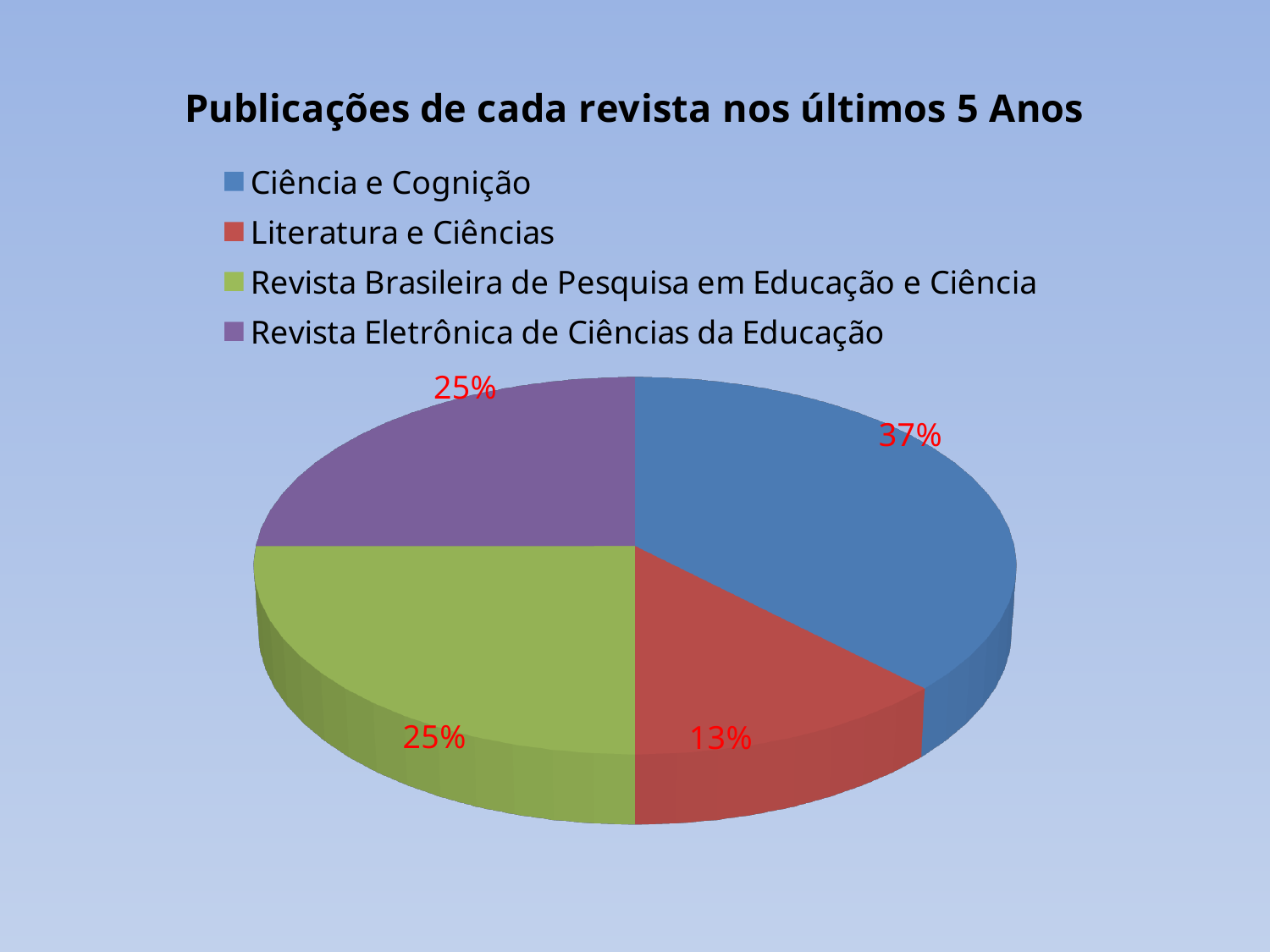
What is the title of the chart? Publicações de cada revista nos últimos 5 Anos What share of the pie does Revista Brasileira de Pesquisa em Educação e Ciência have? 25% Which journal has the smallest slice of the pie? Literatura e Ciências What share of the pie does Revista Eletrônica de Ciências da Educação have? 25% What share of the pie does Ciência e Cognição have? 37% Which is larger, the slice for Ciência e Cognição or the slice for Revista Eletrônica de Ciências da Educação? Ciência e Cognição How many slices does the pie chart have? 4 What is the difference in percentage points between Ciência e Cognição and Literatura e Ciências? 24 Which journal has the largest slice of the pie? Ciência e Cognição What kind of chart is shown on the slide? Pie chart What colour is the slice for Literatura e Ciências? Red